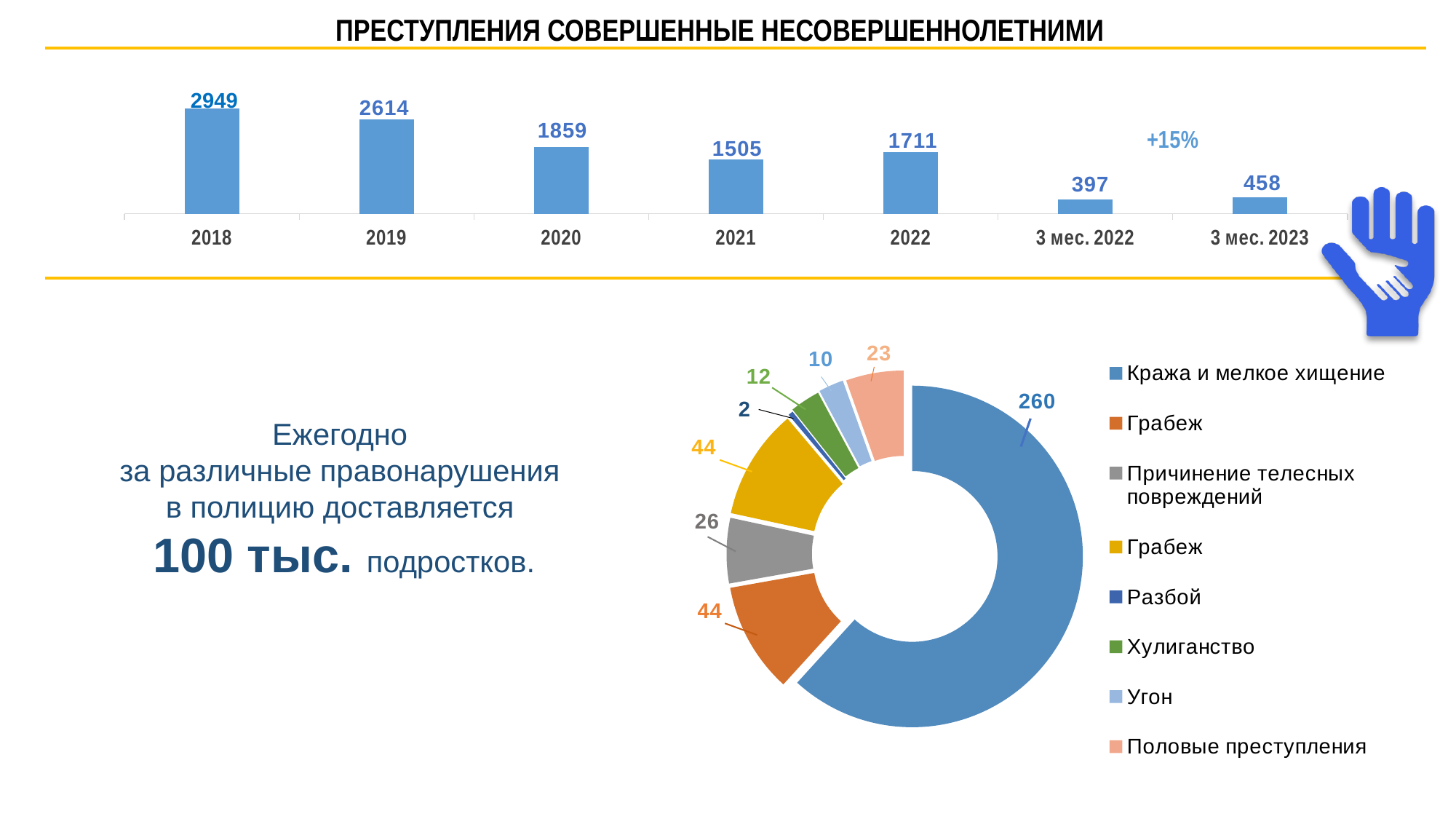
In the bottom doughnut chart, which category has the smallest value? Разбой In the top bar chart, which is larger, the value for 2021 or the value for 2022? 2022 In the top bar chart, what is the value for 2018? 2949 What kind of chart is the chart at the bottom of the slide? doughnut (pie) chart In the top bar chart, what is the difference between the values for 2018 and 2019? 335 In the top bar chart, do the values rise or fall from 2018 to 2021? fall In the top bar chart, what is the difference between the values for 3 мес. 2023 and 3 мес. 2022? 61 In the top bar chart, what is the value for 2020? 1859 In the bottom doughnut chart, what is the value for Кража и мелкое хищение? 260 In the top bar chart, which category has the highest value? 2018 How many bars are shown in the top bar chart? 7 In the top bar chart, which category has the lowest value? 3 мес. 2022